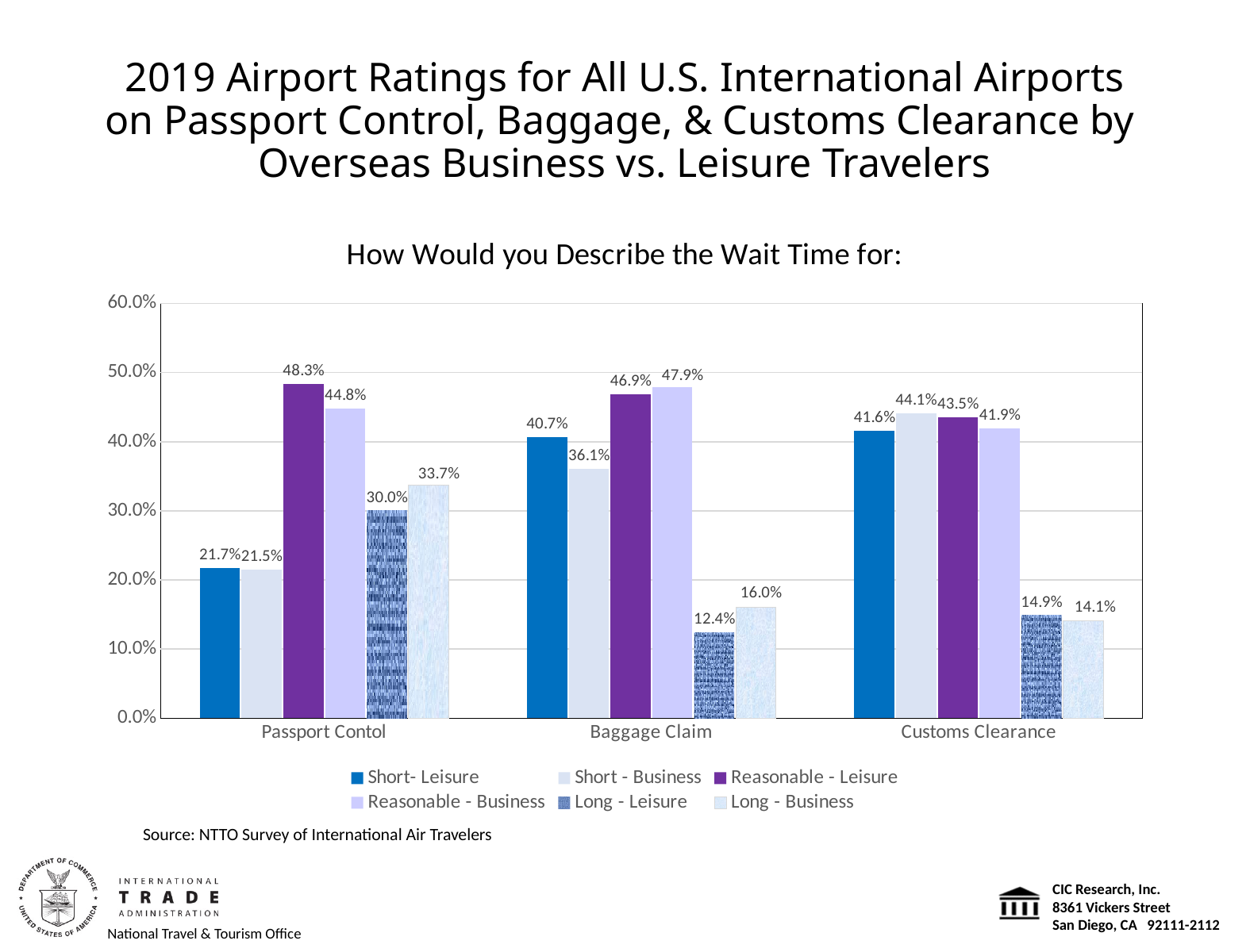
Is the value for Long - Leisure in the Baggage Claim category greater or less than 20.0%? less How many categories are shown on the x axis? 3 What kind of chart is shown on the slide? bar chart What is the value for Reasonable - Leisure in the Passport Contol category? 48.3% Which series has the highest value in the Baggage Claim category? Reasonable - Business How many series does the legend list? 6 What is the value for Long - Business in the Baggage Claim category? 16.0% What is the value for Short - Business in the Customs Clearance category? 44.1% Which series has the lowest value in the Customs Clearance category? Long - Business Which is larger in the Baggage Claim category: Short- Leisure or Short - Business? Short- Leisure What is the difference between Long - Business and Long - Leisure in the Passport Contol category? 3.7% What is the chart's title? How Would you Describe the Wait Time for: